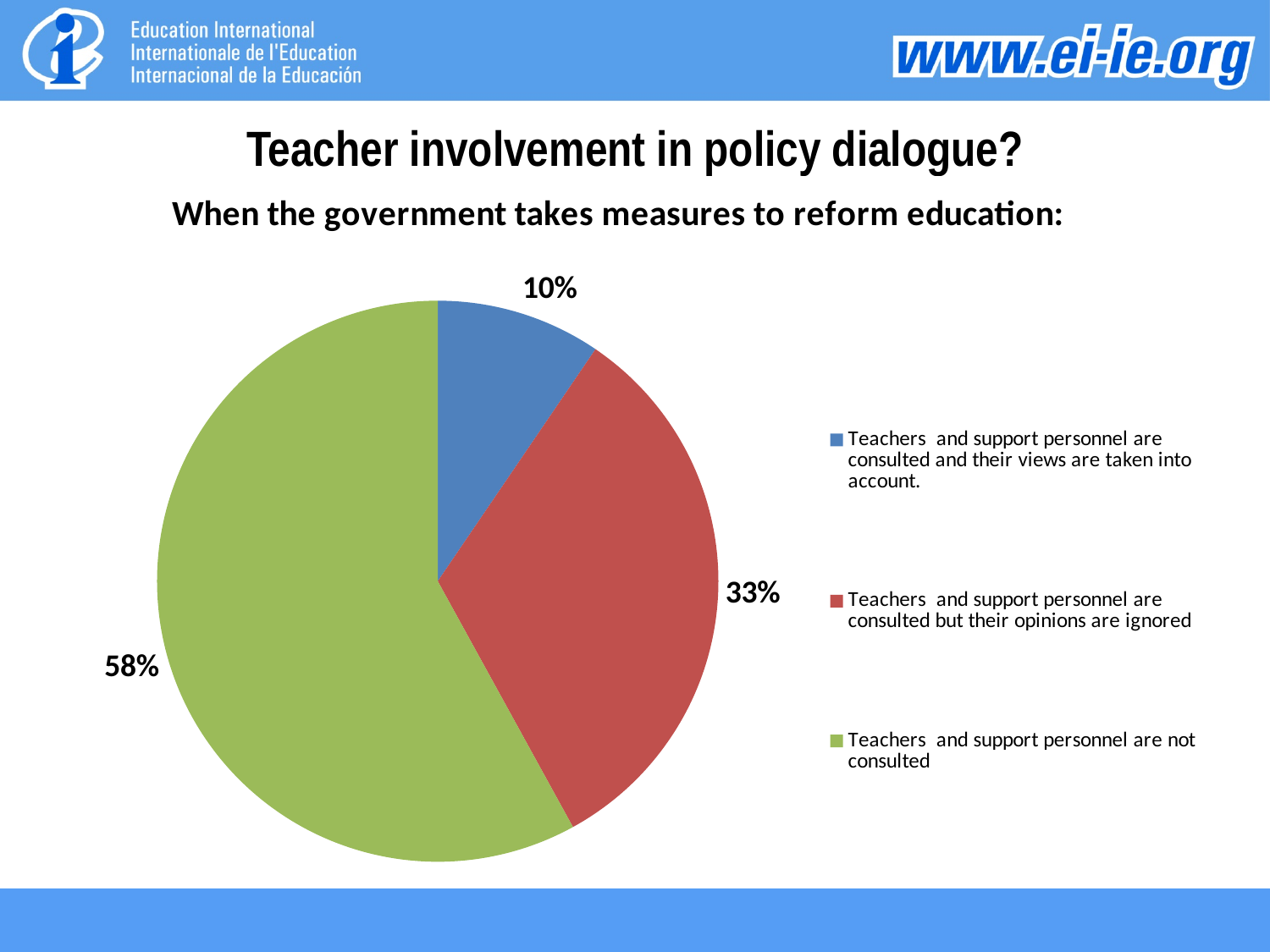
What is the difference in percentage points between the 'not consulted' slice and the 'consulted but their opinions are ignored' slice? 25 How many slices does the pie chart have? 3 Which category has the largest slice of the pie? Teachers and support personnel are not consulted How many entries does the legend list? 3 Which category has the smallest slice of the pie? Teachers and support personnel are consulted and their views are taken into account. What kind of chart is shown on the slide? pie chart Which is larger: the slice for 'consulted but their opinions are ignored' or the slice for 'consulted and their views are taken into account'? Teachers and support personnel are consulted but their opinions are ignored What share of the pie is for 'Teachers and support personnel are consulted and their views are taken into account'? 10% What is the chart's title? When the government takes measures to reform education: What colour is the slice for 'Teachers and support personnel are not consulted'? green What share of the pie is for 'Teachers and support personnel are not consulted'? 58% What share of the pie is for 'Teachers and support personnel are consulted but their opinions are ignored'? 33%